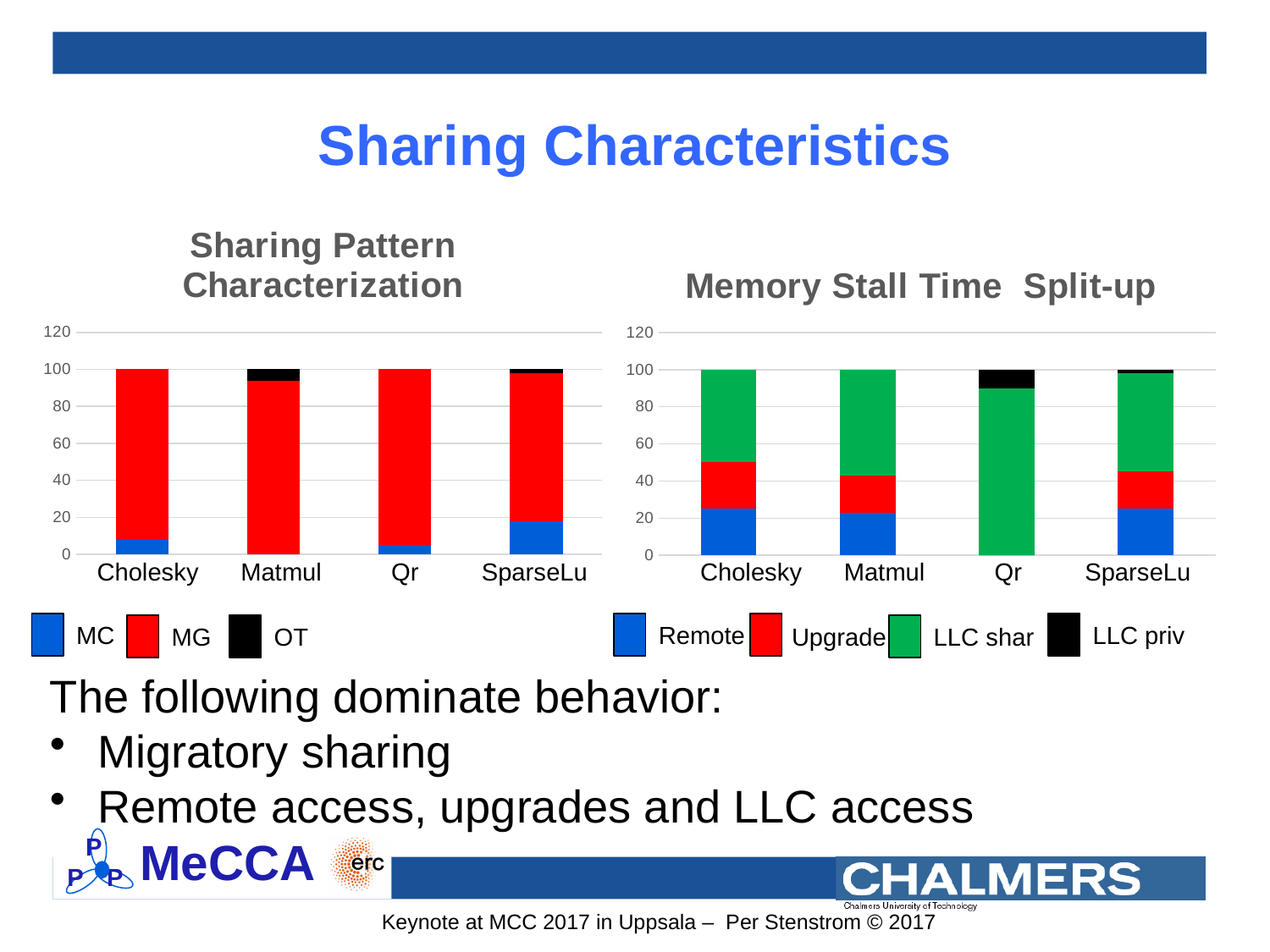
In the Memory Stall Time Split-up chart, which category has the largest LLC shar segment? Qr In the Sharing Pattern Characterization chart, is the MC value for SparseLu greater or less than 20? less How many series does the legend of the Memory Stall Time Split-up chart list? 4 How many series does the legend of the Sharing Pattern Characterization chart list? 3 What kind of chart is the Sharing Pattern Characterization chart on the left? stacked bar chart In the Sharing Pattern Characterization chart, which is larger, the MC value for SparseLu or the MC value for Cholesky? SparseLu In the Memory Stall Time Split-up chart, what is the total height of the stacked bar for Cholesky? 100 In the Sharing Pattern Characterization chart, is the MG value for Qr greater or less than 80? greater How many categories are shown on the x axis of the Memory Stall Time Split-up chart? 4 In the Memory Stall Time Split-up chart, is the LLC shar value for Qr greater or less than 80? greater Which colour represents the Upgrade series in the Memory Stall Time Split-up chart? red